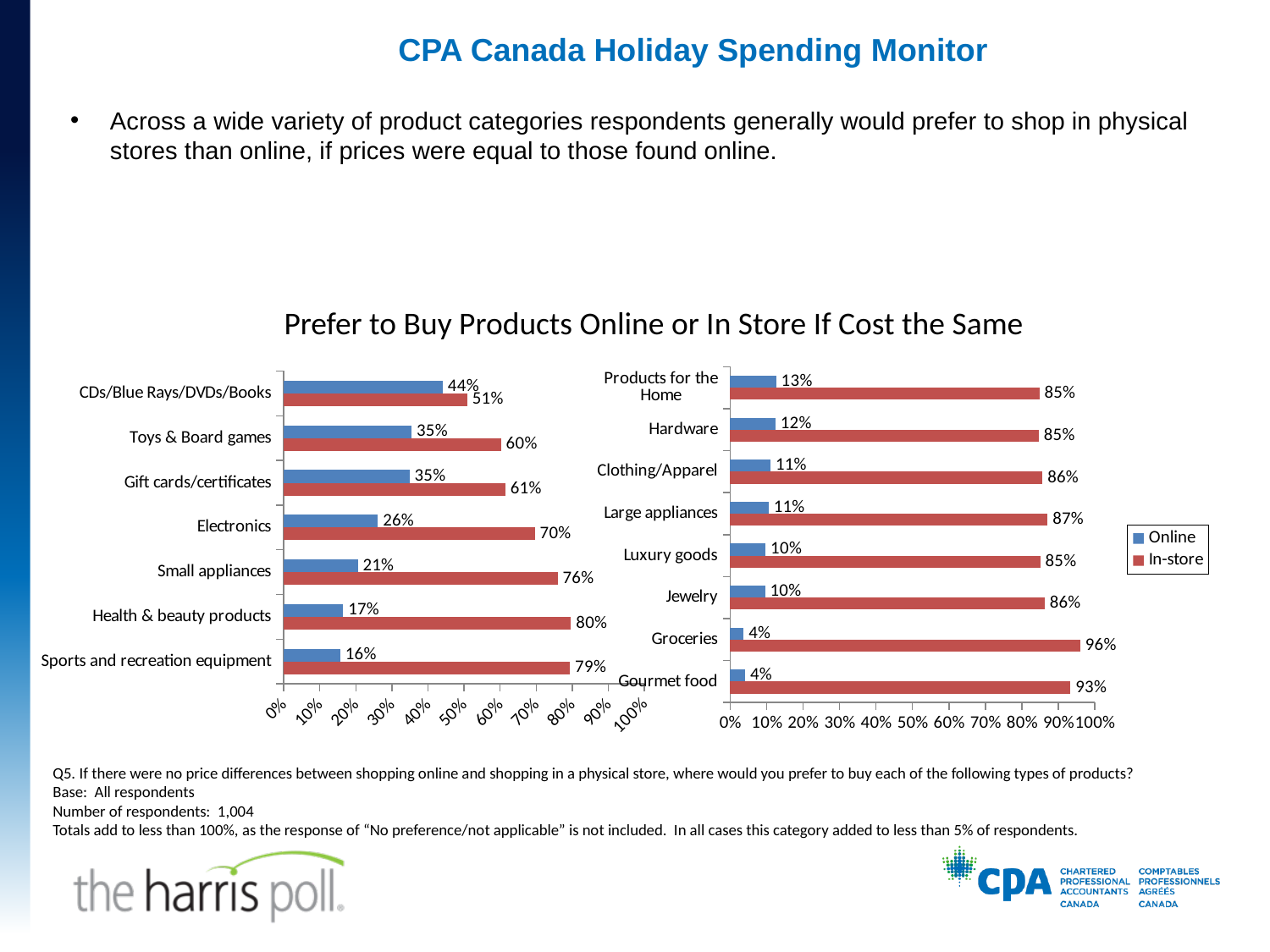
What is the title of the chart on the slide? Prefer to Buy Products Online or In Store If Cost the Same In the left chart, which category has the lowest Online value? Sports and recreation equipment In the right chart, which category has the highest In-store value? Groceries How many product categories are shown in the right chart? 8 How many series does the legend list? 2 In the left chart, what is the Online value for CDs/Blue Rays/DVDs/Books? 44% In the right chart, which is larger: the In-store value for Gourmet food or the In-store value for Jewelry? Gourmet food In the left chart, what is the difference between the In-store and Online values for Small appliances? 55% How many product categories are shown in the left chart? 7 In the left chart, what percentage of respondents prefer to buy Electronics in-store? 70% In the right chart, what percentage of respondents prefer to buy Groceries online? 4% What type of chart is used on this slide? Bar chart